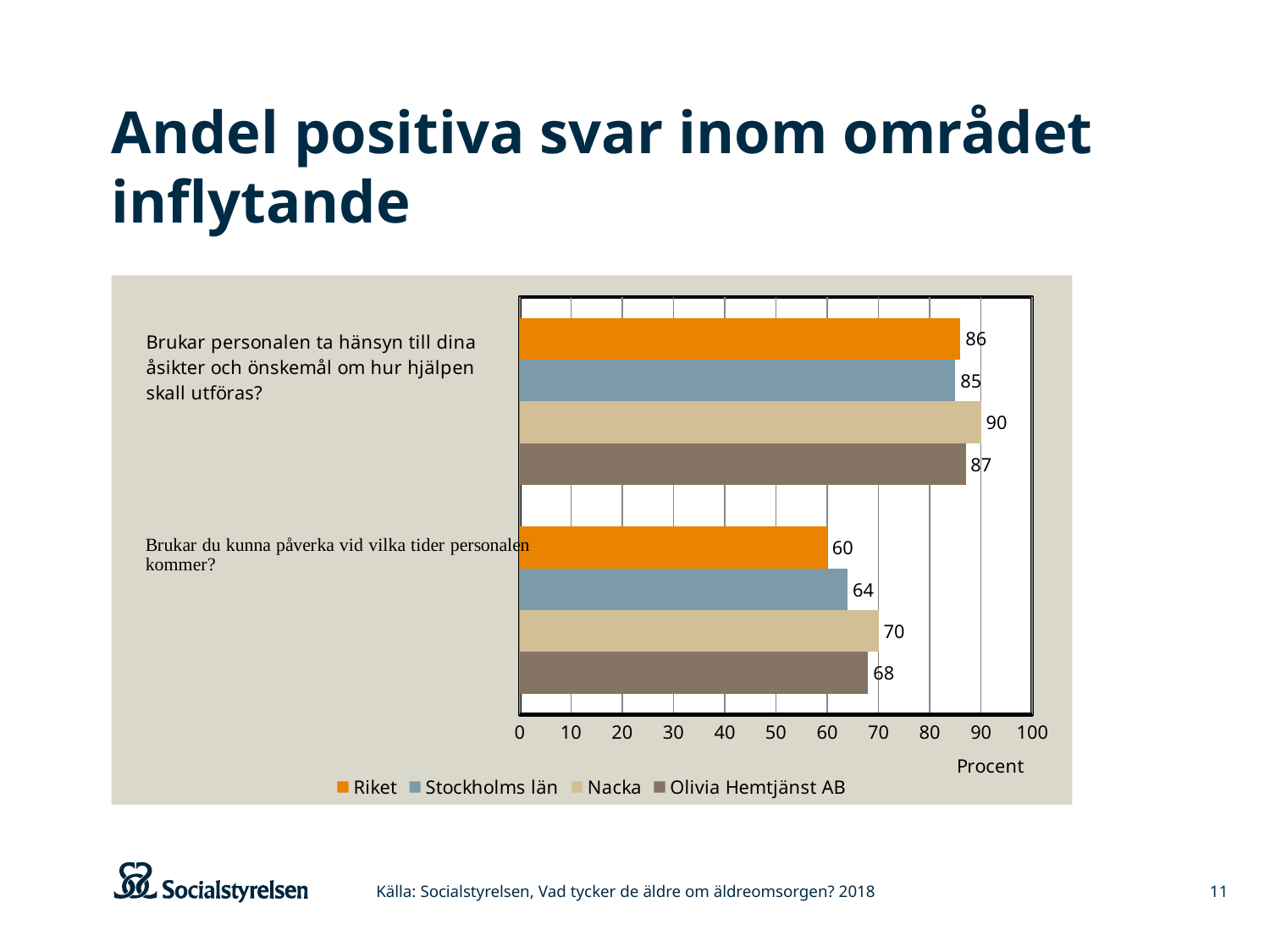
Which series has the highest value on the question 'Brukar du kunna påverka vid vilka tider personalen kommer?' Nacka What is the value for Olivia Hemtjänst AB on the question 'Brukar du kunna påverka vid vilka tider personalen kommer?' 68 How many questions (categories) are shown on the chart? 2 Which series has the lowest value on the question 'Brukar personalen ta hänsyn till dina åsikter och önskemål om hur hjälpen skall utföras?' Stockholms län What is the label of the horizontal axis? Procent What is the difference between the Nacka and Riket values on the question 'Brukar du kunna påverka vid vilka tider personalen kommer?' 10 What is the value for Nacka on the question 'Brukar personalen ta hänsyn till dina åsikter och önskemål om hur hjälpen skall utföras?' 90 What kind of chart is shown on the slide? Bar chart How many series does the legend list? 4 What is the value for Riket on the question 'Brukar du kunna påverka vid vilka tider personalen kommer?' 60 What is the value for Stockholms län on the question 'Brukar personalen ta hänsyn till dina åsikter och önskemål om hur hjälpen skall utföras?' 85 Which is larger on the question 'Brukar personalen ta hänsyn till dina åsikter och önskemål om hur hjälpen skall utföras?': Olivia Hemtjänst AB or Riket? Olivia Hemtjänst AB